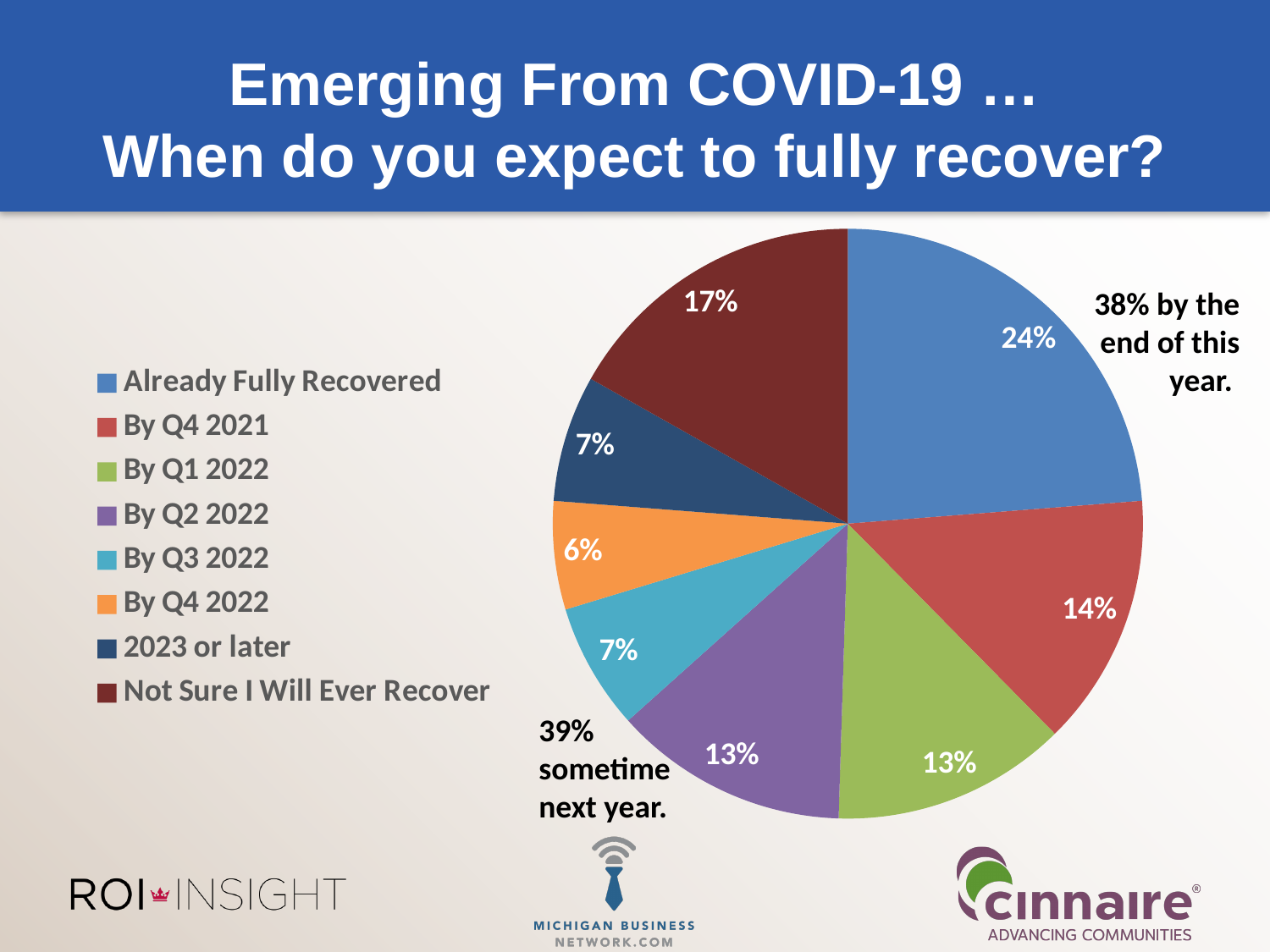
What percentage of respondents expect to recover in 2023 or later? 7% What kind of chart is shown on the slide? pie chart What percentage of respondents expect to recover By Q4 2022? 6% Which category has the largest share of the pie? Already Fully Recovered How many categories does the legend list? 8 What share of respondents said they have Already Fully Recovered? 24% Which category has the smallest share of the pie? By Q4 2022 According to the annotation on the slide, what percentage expect to recover sometime next year? 39% Which is larger, the share for Not Sure I Will Ever Recover or the share for By Q1 2022? Not Sure I Will Ever Recover What percentage of respondents said Not Sure I Will Ever Recover? 17% What is the difference in percentage points between Already Fully Recovered and By Q4 2021? 10 What percentage of respondents expect to recover By Q4 2021? 14%